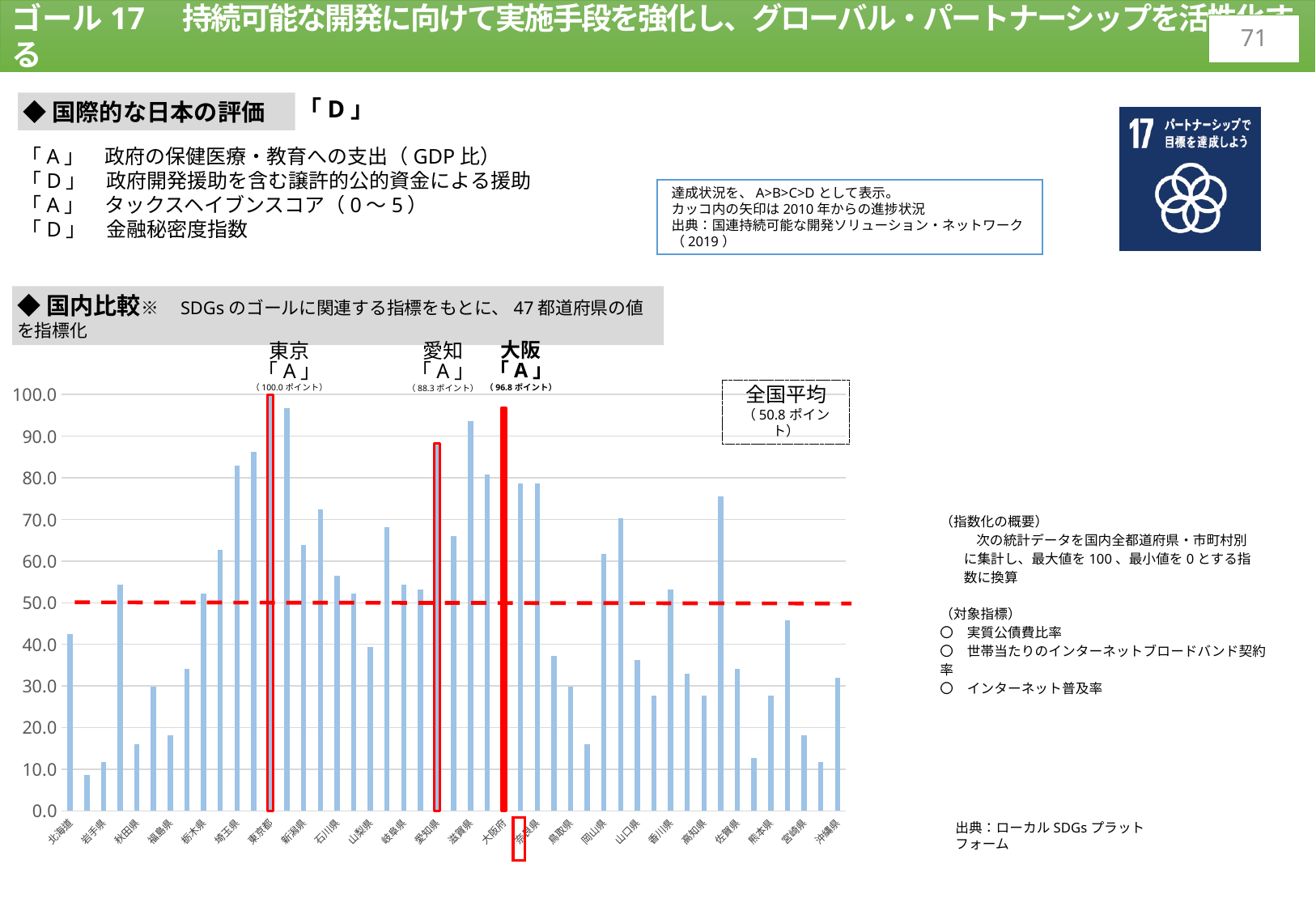
What is the difference between the values for 大阪 and 愛知? 8.5 ポイント What does the red dashed horizontal line on the chart represent? 全国平均 (50.8 ポイント) Which prefecture has the highest value on the chart? 東京都 What is the value for 東京 (Tokyo) shown on the chart? 100.0 ポイント What kind of chart is shown on the slide? bar chart What is the value for 大阪 (Osaka) shown on the chart? 96.8 ポイント What is the value for 愛知 (Aichi) shown on the chart? 88.3 ポイント Is the value for 岩手県 greater or less than 20.0? less What is the 全国平均 (national average) value shown on the chart? 50.8 ポイント Which has the larger value, 大阪 or 愛知? 大阪 Is the value for 北海道 greater or less than 50.0? less What is the difference between the values for 東京 and 大阪? 3.2 ポイント